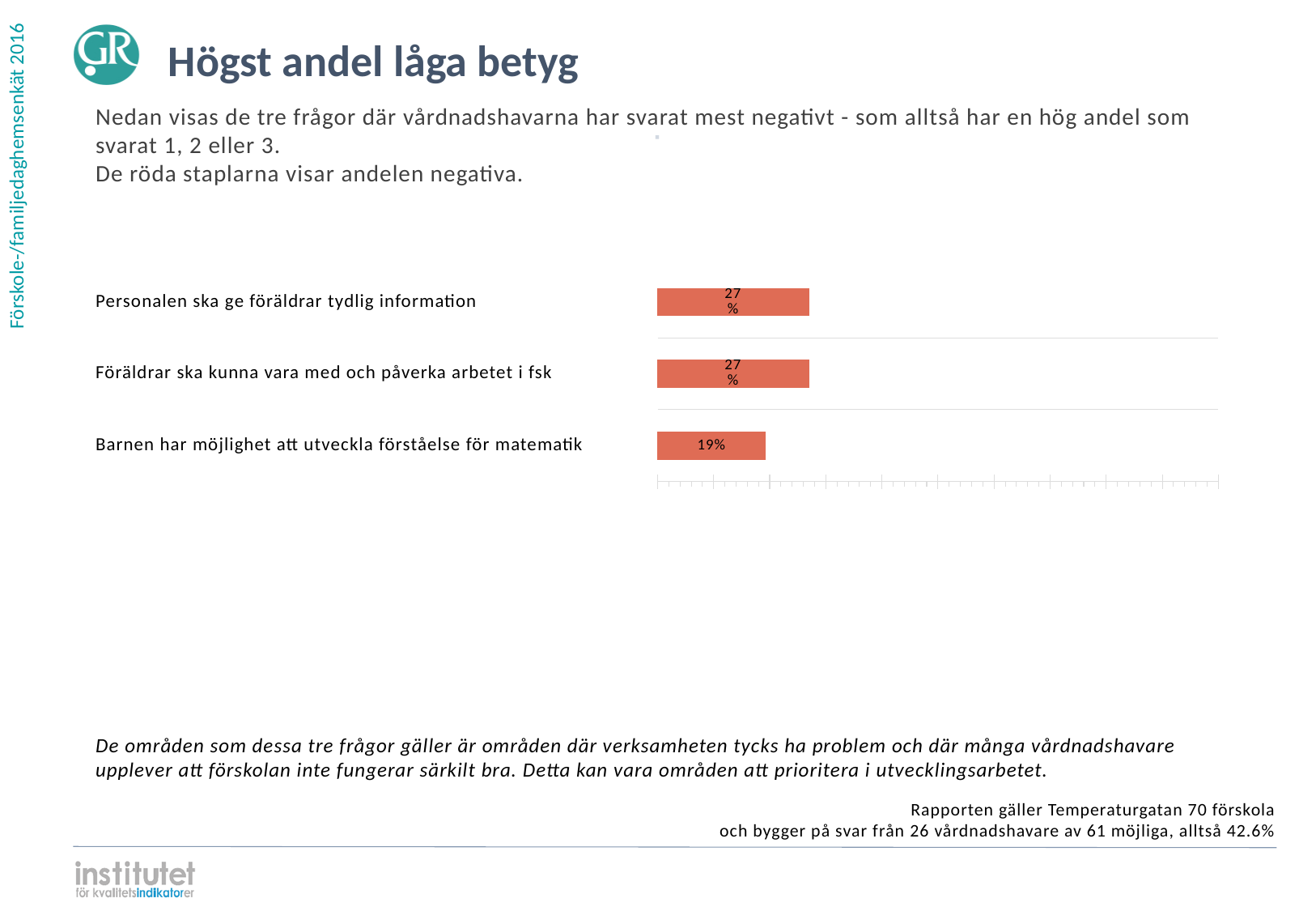
Which category has the lowest value? Barnen har möjlighet att utveckla förståelse för matematik What is the title of the slide containing the chart? Högst andel låga betyg What is the value for "Personalen ska ge föräldrar tydlig information"? 27% What colour are the bars in the chart? Red How many categories are shown in the chart? 3 Which is larger: the value for "Föräldrar ska kunna vara med och påverka arbetet i fsk" or the value for "Barnen har möjlighet att utveckla förståelse för matematik"? Föräldrar ska kunna vara med och påverka arbetet i fsk What is the value for "Föräldrar ska kunna vara med och påverka arbetet i fsk"? 27% What kind of chart is shown on the slide? Bar chart What is the value for "Barnen har möjlighet att utveckla förståelse för matematik"? 19% What is the difference between the value for "Personalen ska ge föräldrar tydlig information" and the value for "Barnen har möjlighet att utveckla förståelse för matematik"? 8 percentage points How many categories have a value of 27%? 2